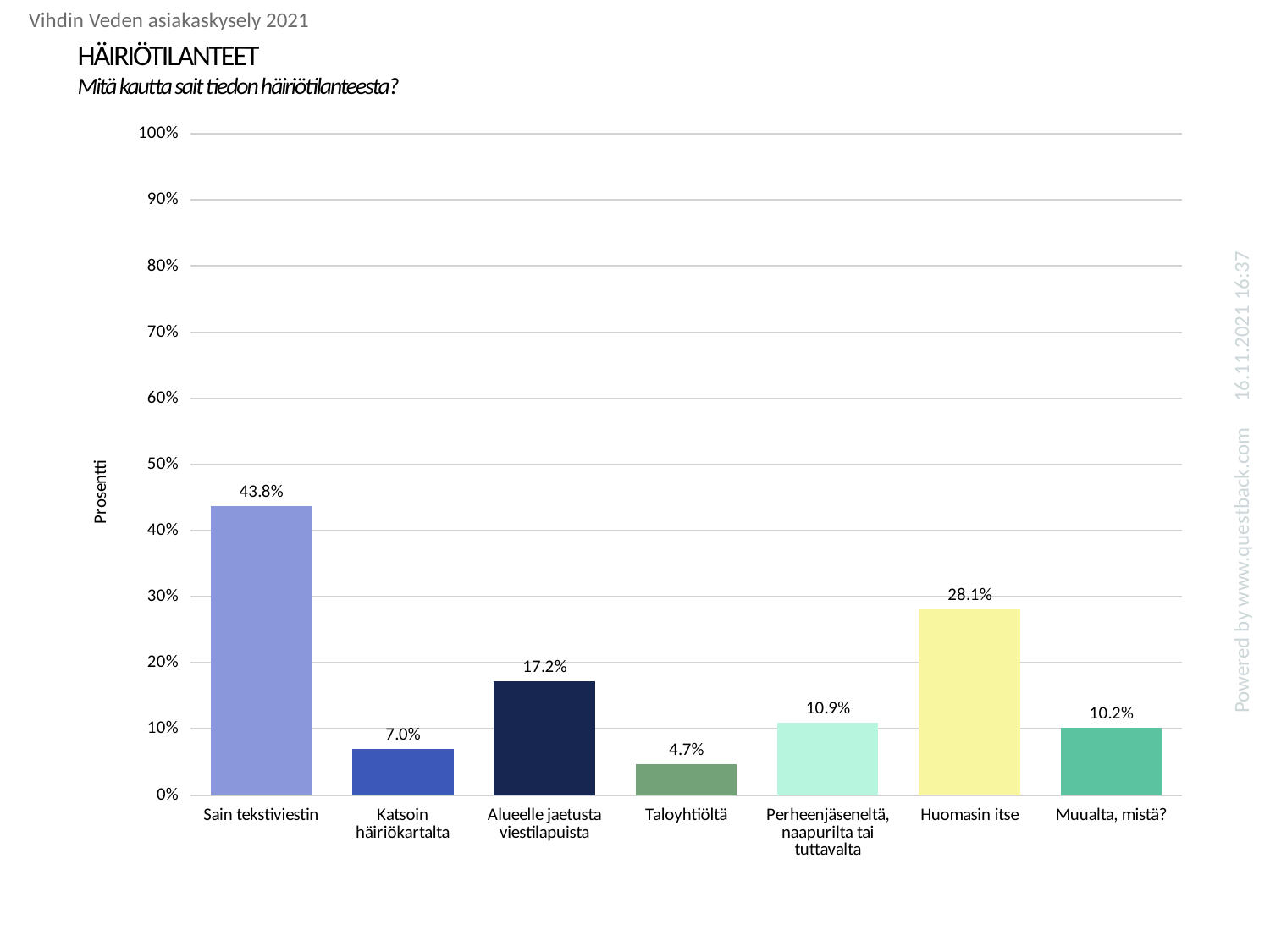
What is the label of the y axis? Prosentti What kind of chart is shown on the slide? bar chart What is the value for "Sain tekstiviestin"? 43.8% How many categories are shown on the x axis? 7 What is the difference between "Sain tekstiviestin" and "Huomasin itse"? 15.7% What is the value for "Perheenjäseneltä, naapurilta tai tuttavalta"? 10.9% Is the value for "Katsoin häiriökartalta" greater or less than 10%? less Which category has the lowest value? Taloyhtiöltä What is the value for "Huomasin itse"? 28.1% Which category has the highest value? Sain tekstiviestin Which is larger: "Alueelle jaetusta viestilapuista" or "Muualta, mistä?"? Alueelle jaetusta viestilapuista What is the value for "Taloyhtiöltä"? 4.7%